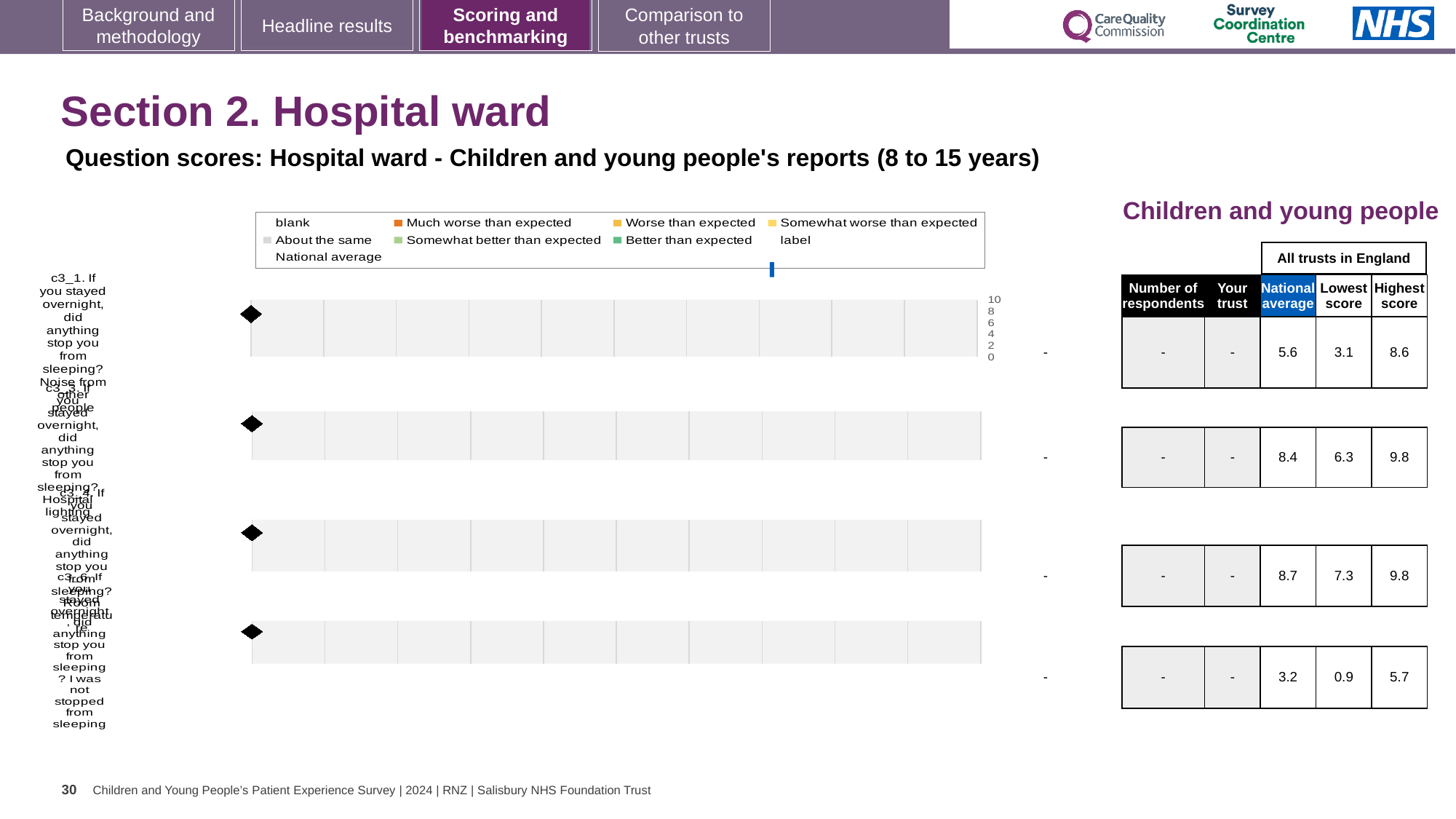
What is the difference between the highest score and the lowest score for c3_1 in the table? 5.5 In the table, what is the lowest score for c3_6 (I was not stopped from sleeping)? 0.9 Which question has the highest national average in the table? c3_4 (room temperature) Which question has the lowest national average in the table? c3_6 (I was not stopped from sleeping) What kind of chart is shown on the slide? bar chart How many entries does the chart legend list? 9 Which has the larger national average in the table: c3_3 (hospital lighting) or c3_4 (room temperature)? c3_4 (room temperature) In the table, what is shown as the 'Your trust' score for c3_4 (room temperature)? - In the table, what is the highest score for c3_3 (hospital lighting)? 9.8 What is the maximum value shown on the chart's axis? 10 How many question categories (bars) does the chart show? 4 In the table, what is the national average for c3_1 (noise from other people)? 5.6